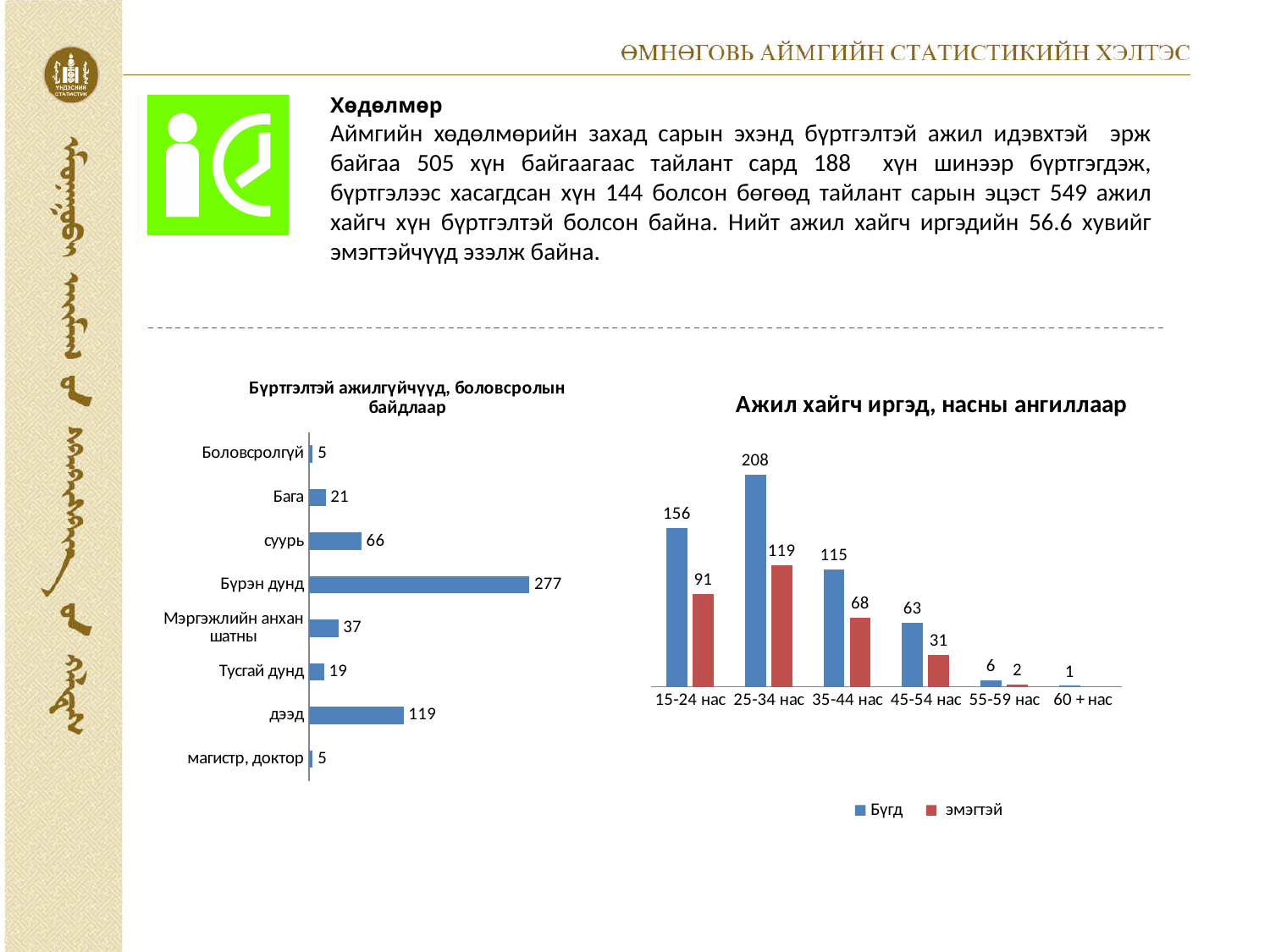
In the chart 'Бүртгэлтэй ажилгүйчүүд, боловсролын байдлаар', what is the value for дээд? 119 In the chart 'Ажил хайгч иргэд, насны ангиллаар', is the Бүгд value for 45-54 нас larger or smaller than the эмэгтэй value for 25-34 нас? Smaller In the chart 'Ажил хайгч иргэд, насны ангиллаар', what is the difference between Бүгд and эмэгтэй for 15-24 нас? 65 In the chart 'Бүртгэлтэй ажилгүйчүүд, боловсролын байдлаар', how many categories are shown? 8 In the chart 'Ажил хайгч иргэд, насны ангиллаар', what is the value of эмэгтэй for 35-44 нас? 68 In the chart 'Ажил хайгч иргэд, насны ангиллаар', how many series does the legend list? 2 In the chart 'Бүртгэлтэй ажилгүйчүүд, боловсролын байдлаар', which category has the highest value? Бүрэн дунд What type of chart is 'Бүртгэлтэй ажилгүйчүүд, боловсролын байдлаар'? Bar chart In the chart 'Ажил хайгч иргэд, насны ангиллаар', which age group has the highest Бүгд value? 25-34 нас In the chart 'Бүртгэлтэй ажилгүйчүүд, боловсролын байдлаар', what is the value for Бүрэн дунд? 277 In the chart 'Бүртгэлтэй ажилгүйчүүд, боловсролын байдлаар', what is the difference between суурь and Бага? 45 In the chart 'Ажил хайгч иргэд, насны ангиллаар', what is the value of Бүгд for 25-34 нас? 208